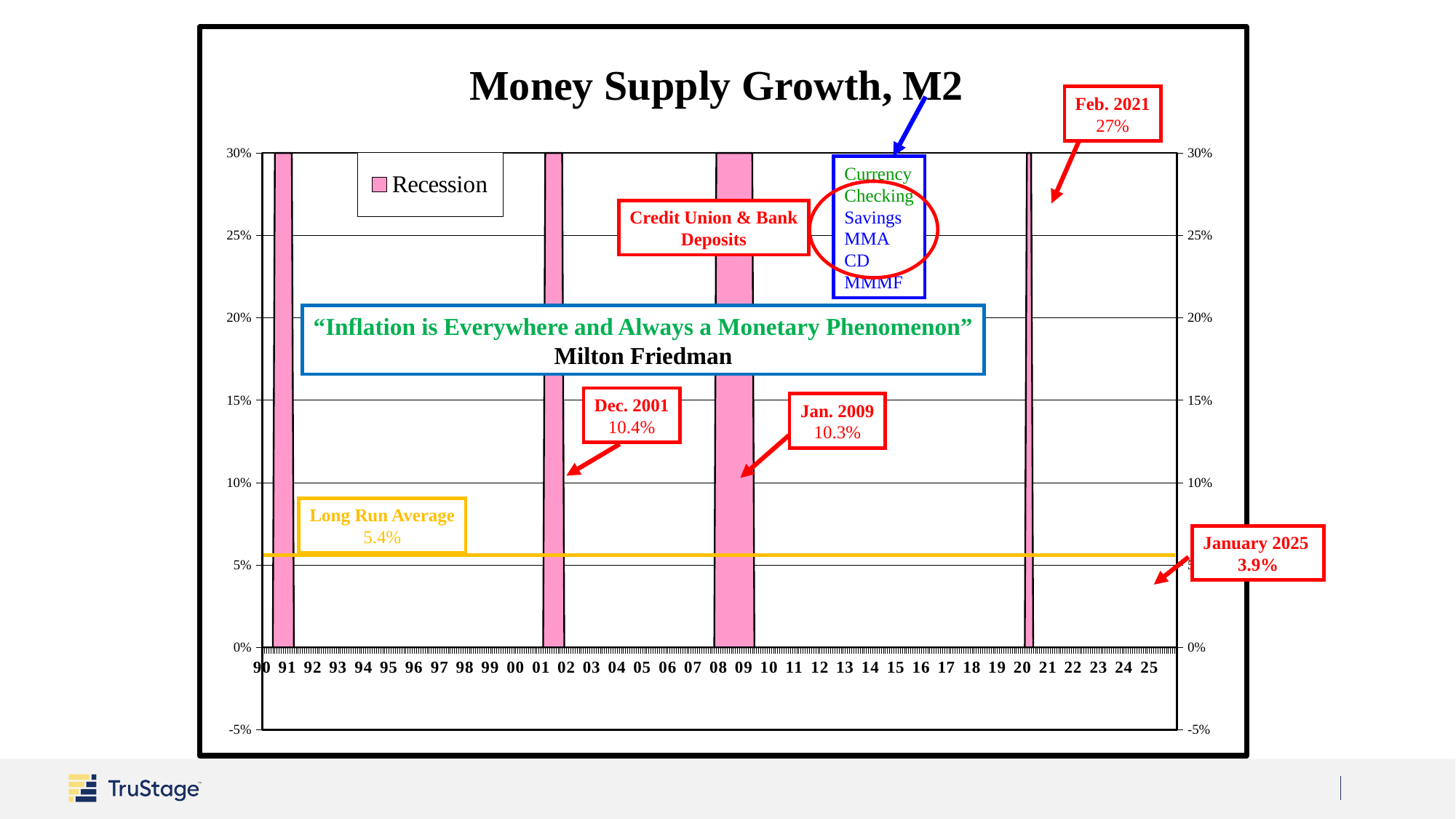
What is the title of the chart? Money Supply Growth, M2 What M2 growth value is annotated for January 2025? 3.9% What M2 growth value is annotated for Feb. 2021? 27% What does the pink shaded area in the legend represent? Recession Which is larger, the Dec. 2001 value or the Jan. 2009 value? Dec. 2001 What is the Long Run Average of M2 growth shown on the chart? 5.4% What M2 growth value is annotated for Dec. 2001? 10.4% Which annotated date has the lowest M2 growth value? January 2025 What M2 growth value is annotated for Jan. 2009? 10.3% Is the January 2025 value greater or less than the Long Run Average of 5.4%? less What is the difference between the Feb. 2021 value and the January 2025 value? 23.1% Which annotated date has the highest M2 growth value? Feb. 2021